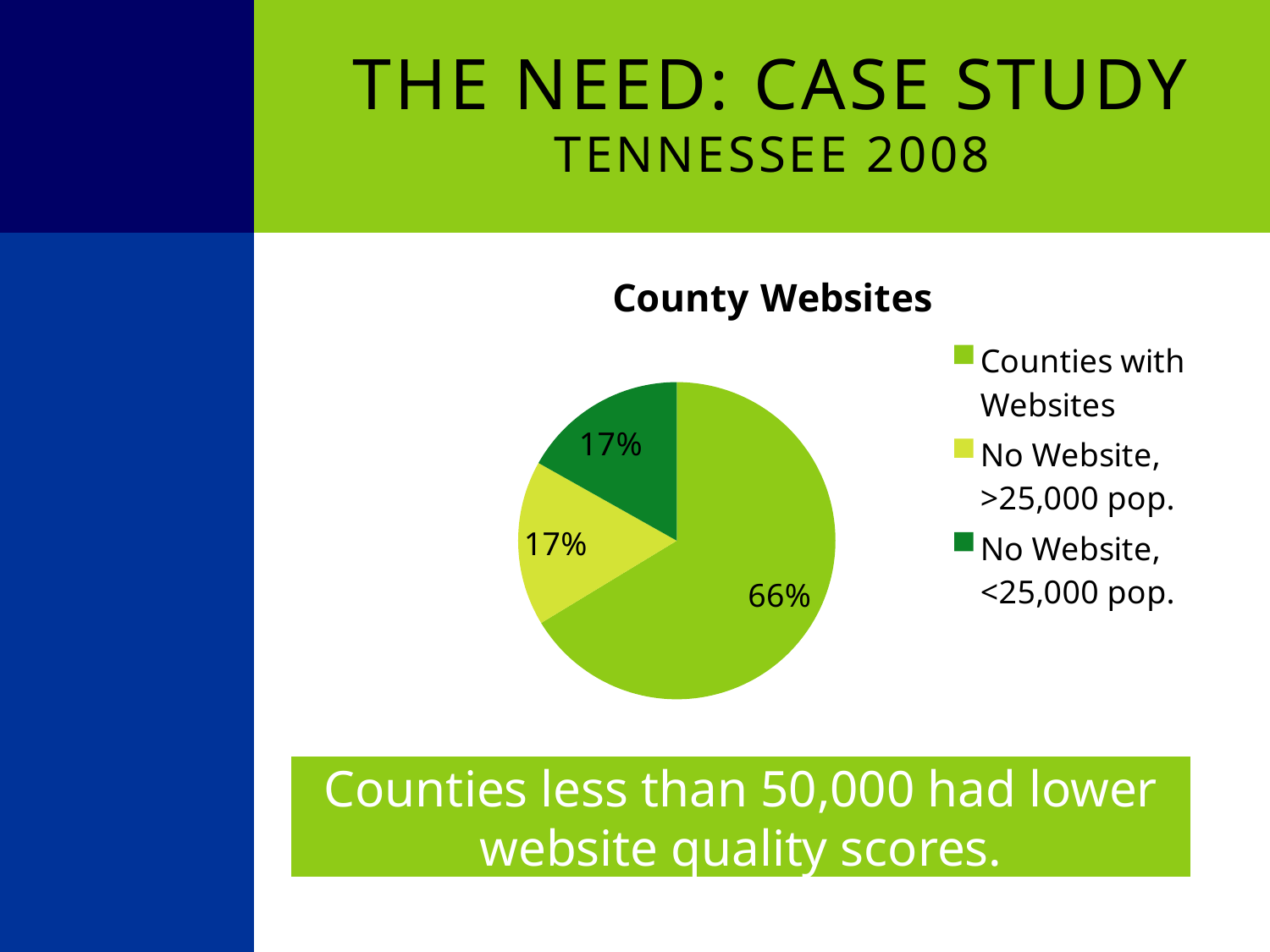
What is the title of the pie chart on the slide? County Websites How many slices does the pie chart have? 3 Which slice is larger: "Counties with Websites" or "No Website, >25,000 pop."? Counties with Websites What percentage of the pie is labelled for "Counties with Websites"? 66% What share of the pie do counties with websites represent? 66% How many entries does the legend of the pie chart list? 3 Which category has the largest slice of the pie? Counties with Websites What is the chart type of the chart titled "County Websites"? pie chart What percentage of the pie is labelled for "No Website, >25,000 pop."? 17% What percentage of the pie is labelled for "No Website, <25,000 pop."? 17% What is the combined share of the two "No Website" slices? 34% What is the difference in percentage points between the "Counties with Websites" slice and the "No Website, <25,000 pop." slice? 49 percentage points